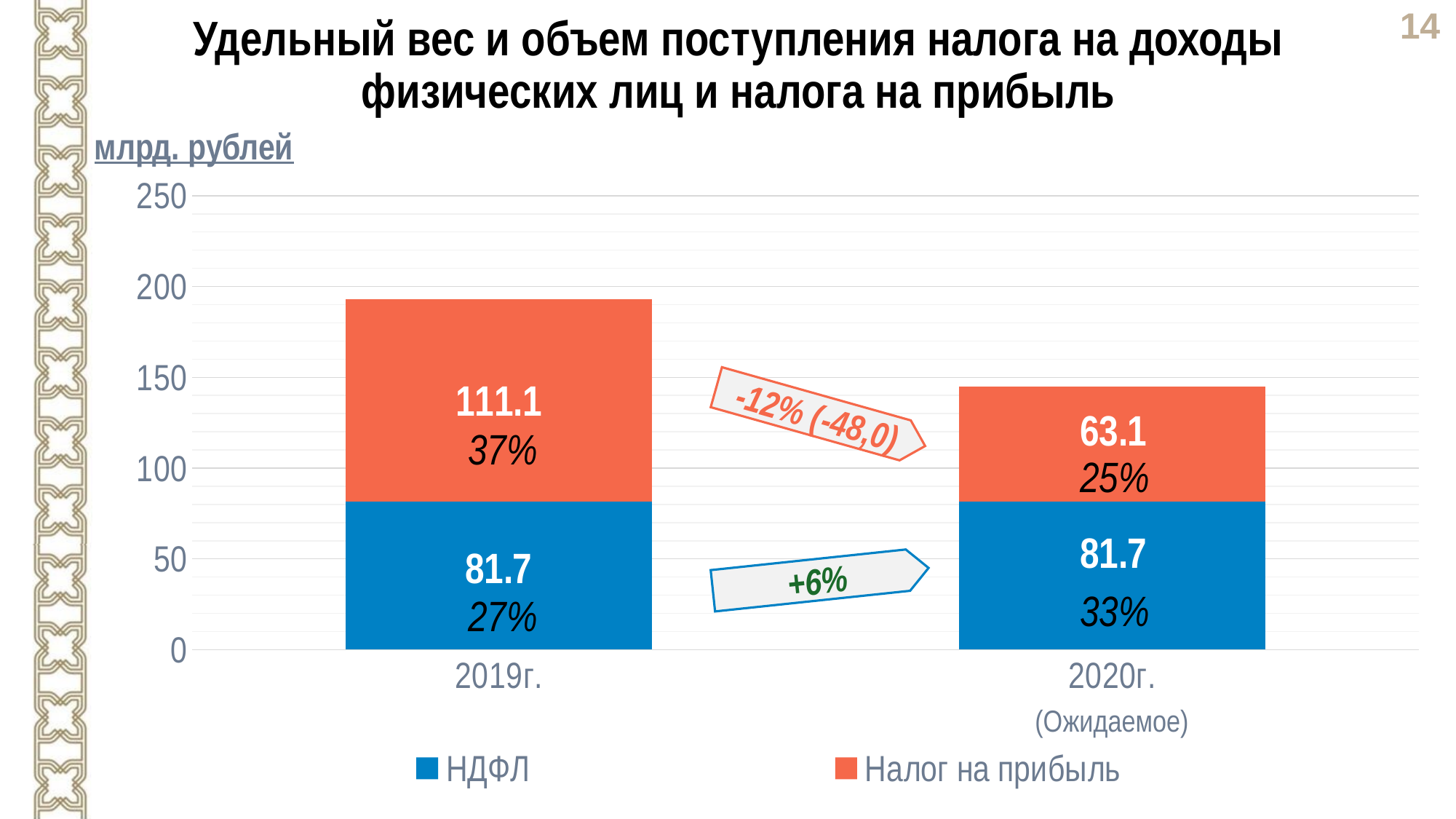
How many categories are shown on the x axis? 2 What unit is stated above the chart? млрд. рублей What type of chart is shown on the slide? stacked bar chart What is the value of НДФЛ for 2020г. (Ожидаемое)? 81.7 What is the difference between the Налог на прибыль values for 2019г. and 2020г. (Ожидаемое)? 48.0 Which is larger in 2019г., НДФЛ or Налог на прибыль? Налог на прибыль What is the value of Налог на прибыль for 2020г. (Ожидаемое)? 63.1 How many series does the legend list? 2 What is the total of the stacked bar for 2019г.? 192.8 What is the value of Налог на прибыль for 2019г.? 111.1 What percentage share is shown for НДФЛ in 2019г.? 27% What percentage share is shown for Налог на прибыль in 2020г. (Ожидаемое)? 25%